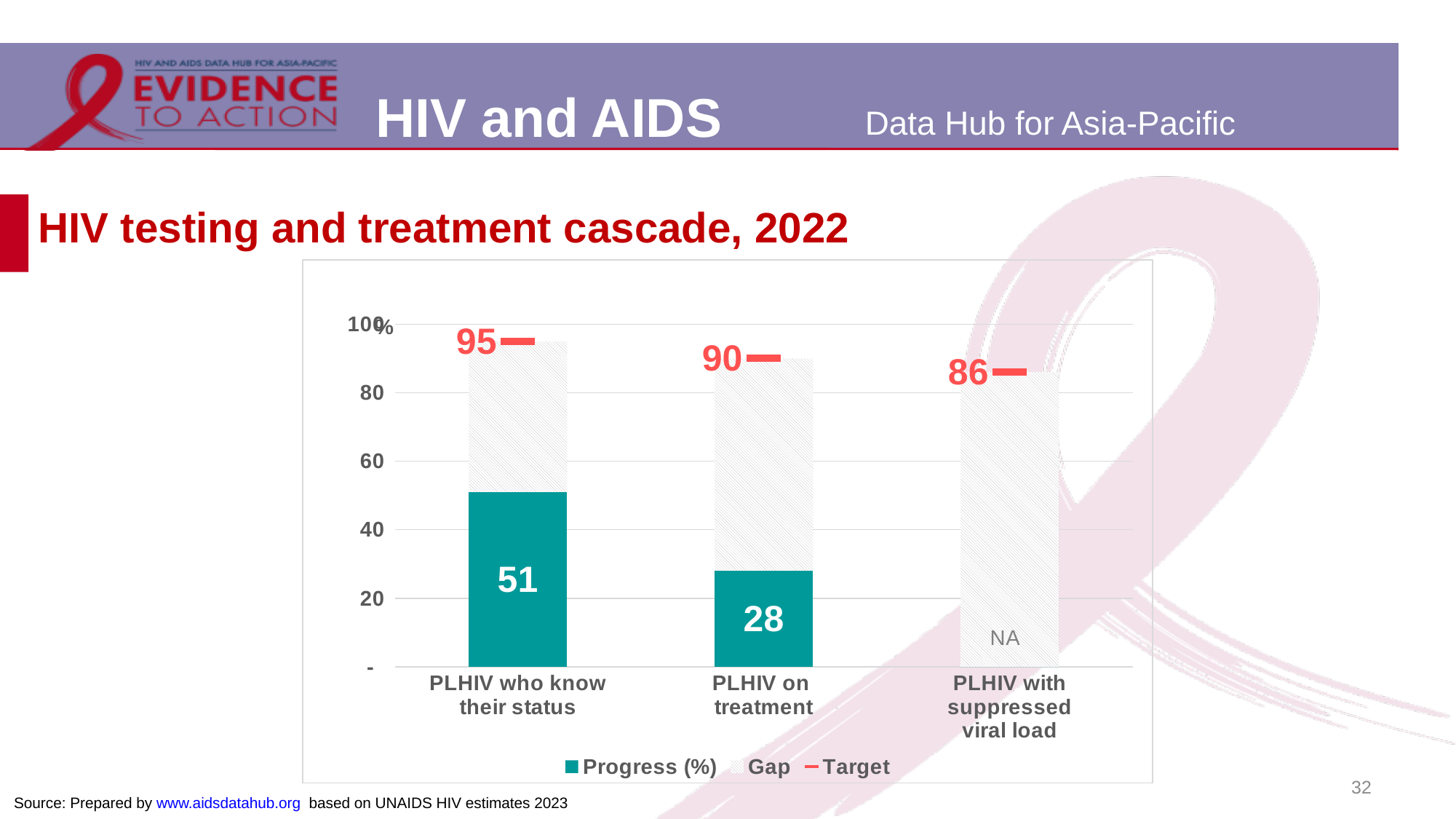
What is the difference between the Progress (%) values for PLHIV who know their status and PLHIV on treatment? 23 How many categories are shown on the x axis of the chart? 3 What is the Target value for PLHIV with suppressed viral load? 86 What is the difference between the Target and the Progress (%) value for PLHIV who know their status? 44 Which category has the lowest Target value? PLHIV with suppressed viral load What is the Progress (%) value for PLHIV who know their status? 51 How many series does the chart legend list? 3 Which has a higher Progress (%) value, PLHIV who know their status or PLHIV on treatment? PLHIV who know their status What is the Target value for PLHIV who know their status? 95 What is the Target value for PLHIV on treatment? 90 What is the Progress (%) value shown for PLHIV with suppressed viral load? NA What is the Progress (%) value for PLHIV on treatment? 28